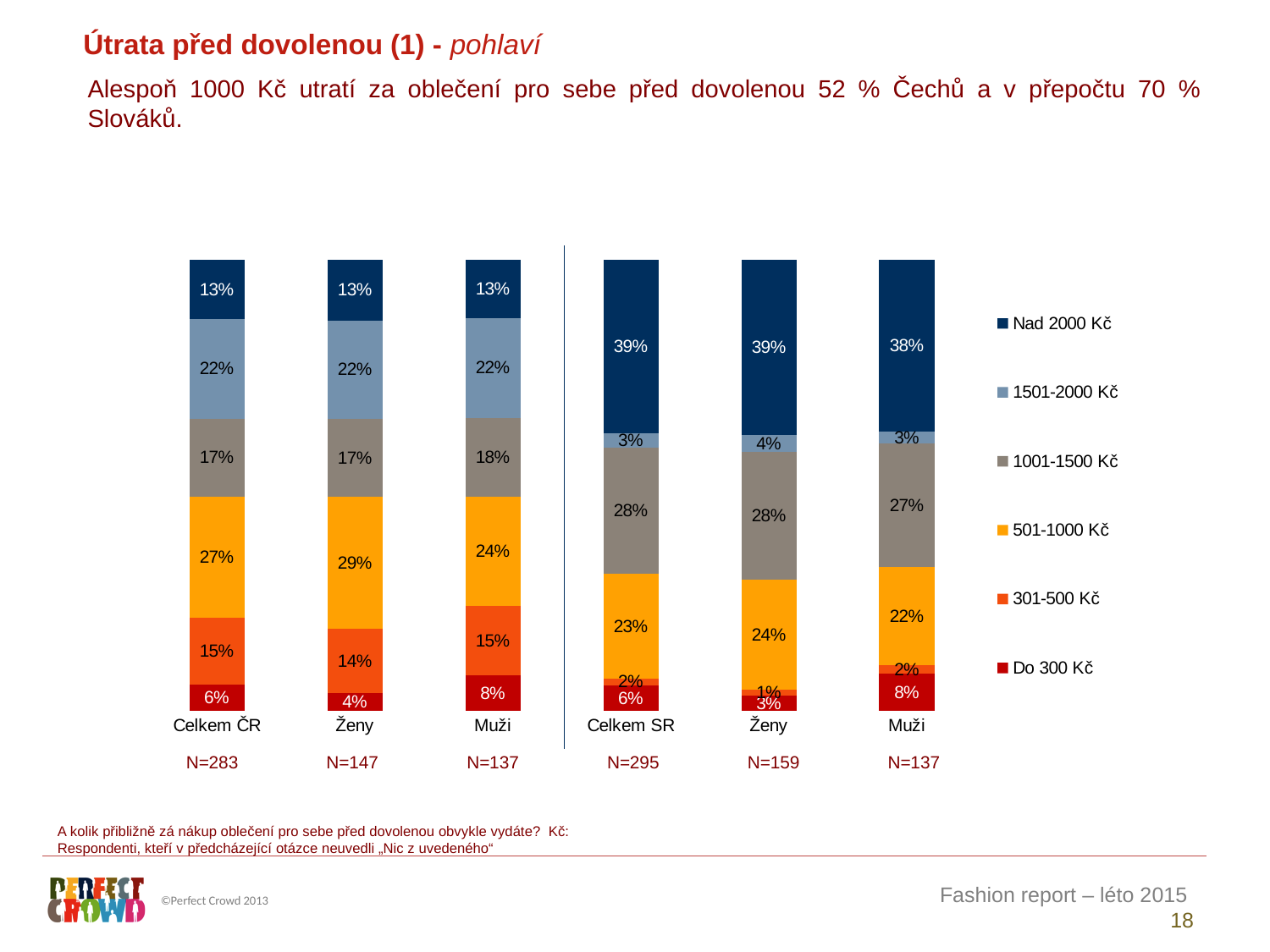
What is the 1001-1500 Kč value for Muži in the ČR group? 18% How many bars (categories) are shown on the chart? 6 What is the 501-1000 Kč value for Ženy in the ČR group? 29% In the ČR group, which has the larger 501-1000 Kč share, Ženy or Muži? Ženy What sample size (N) is shown under the Celkem ČR bar? N=283 What is the difference in the Nad 2000 Kč share between Celkem SR and Celkem ČR? 26 percentage points Which bar has the highest 501-1000 Kč share? Ženy (ČR group) What kind of chart is shown on the slide? Stacked bar chart What is the 301-500 Kč value for Celkem SR? 2% What percentage of Celkem SR respondents fall in the Nad 2000 Kč category? 39% How many series does the legend list? 6 What is the Do 300 Kč value for Muži in the SR group? 8%